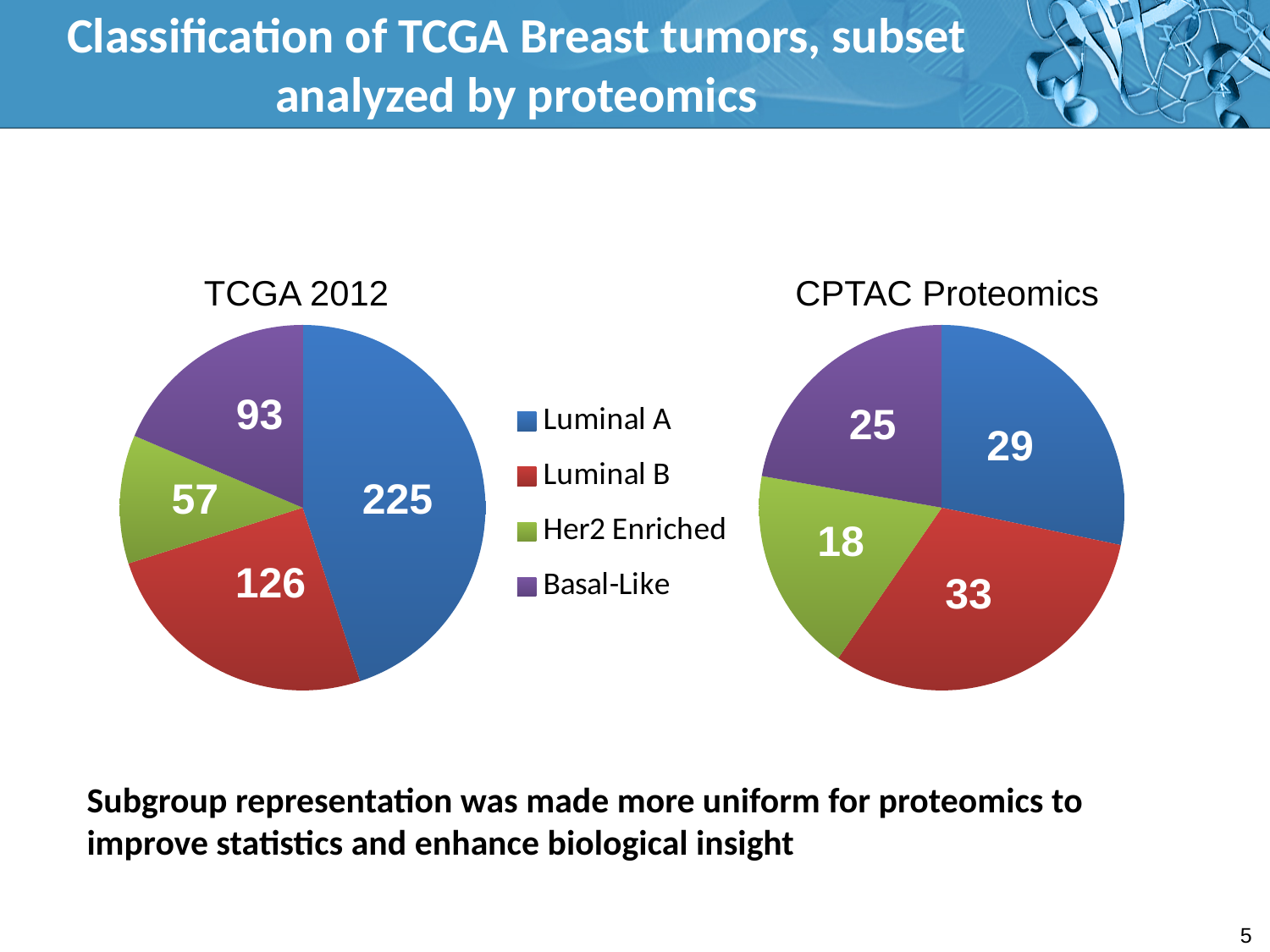
In the CPTAC Proteomics pie chart, is the value for Luminal B larger or smaller than the value for Luminal A? larger What is the total of all slices in the TCGA 2012 pie chart? 501 In the CPTAC Proteomics pie chart, what is the value for Her2 Enriched? 18 In the CPTAC Proteomics pie chart, what is the value for Basal-Like? 25 What type of chart is used for TCGA 2012 and CPTAC Proteomics? Pie chart In the CPTAC Proteomics pie chart, which category has the smallest slice? Her2 Enriched In the CPTAC Proteomics pie chart, which category has the largest slice? Luminal B In the TCGA 2012 pie chart, what is the difference between the Luminal A and Luminal B values? 99 What is the total of all slices in the CPTAC Proteomics pie chart? 105 In the TCGA 2012 pie chart, what is the value for Luminal A? 225 In the TCGA 2012 pie chart, which category has the largest slice? Luminal A How many categories does the legend list? 4